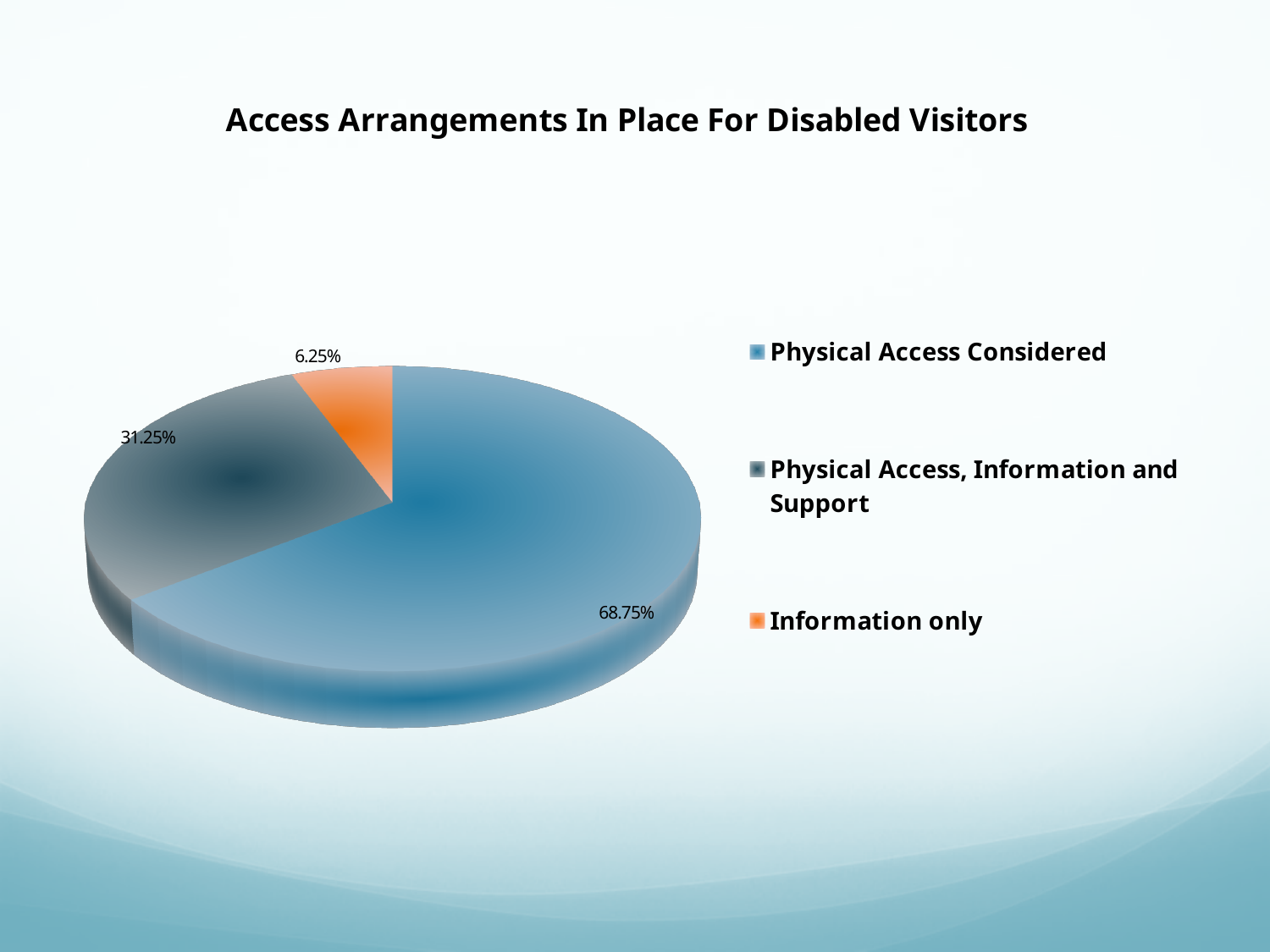
What is the difference in percentage points between Physical Access Considered and Physical Access, Information and Support? 37.5 What share of the pie does Physical Access Considered represent? 68.75% What is the title of the chart? Access Arrangements In Place For Disabled Visitors Which category has the smallest slice of the pie? Information only Which category has the largest slice of the pie? Physical Access Considered How many categories are shown in the pie chart? 3 Which is larger: the slice for Physical Access, Information and Support or the slice for Information only? Physical Access, Information and Support What share of the pie does Information only represent? 6.25% What is the difference in percentage points between Physical Access, Information and Support and Information only? 25 What kind of chart is shown on the slide? Pie chart What share of the pie does Physical Access, Information and Support represent? 31.25% What colour is the slice for Information only? Orange